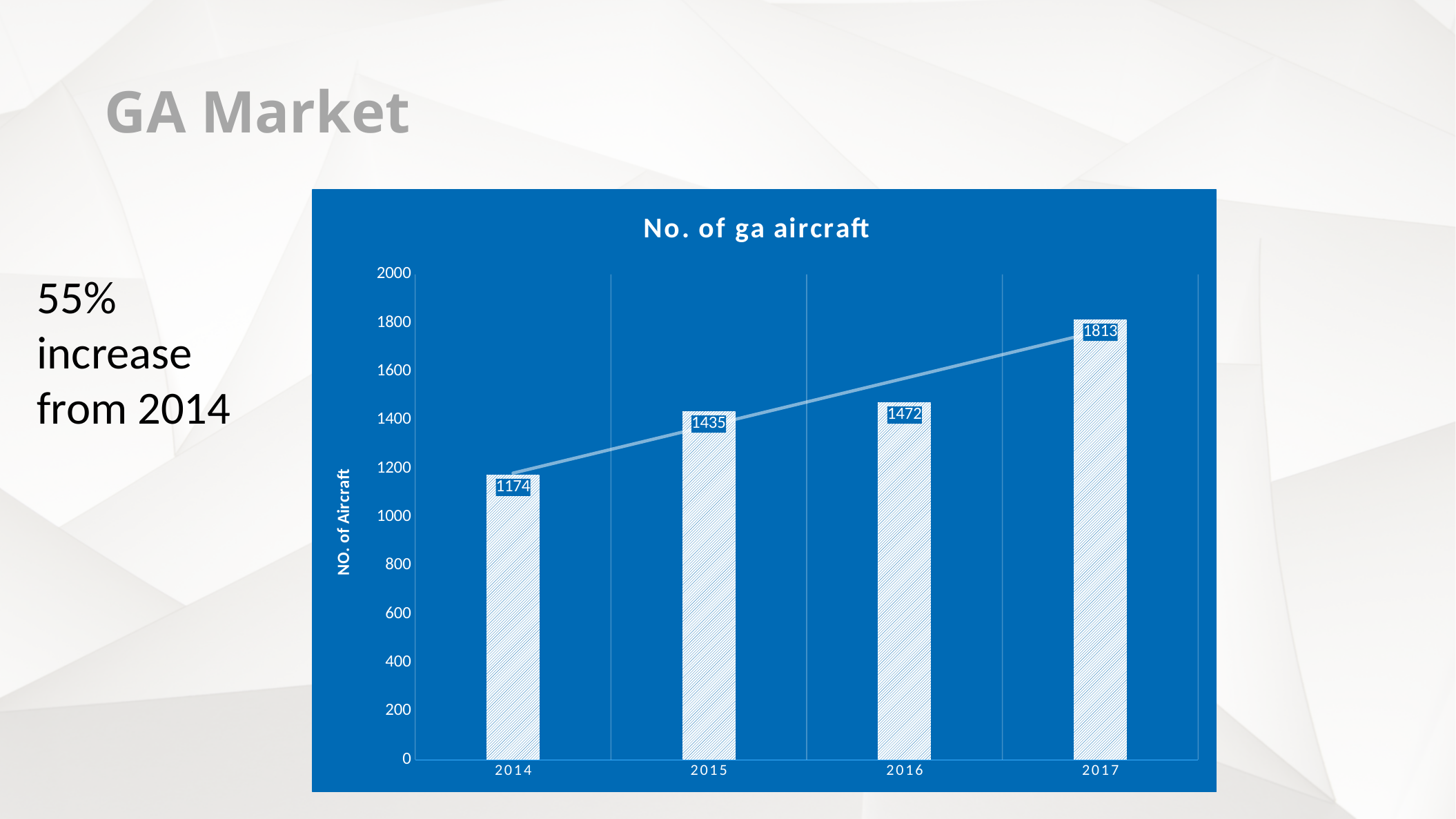
What is the number of GA aircraft in 2014? 1174 What is the difference in the number of GA aircraft between 2016 and 2015? 37 How many years are shown on the x axis of the chart? 4 What kind of chart is used to show the number of GA aircraft? Bar chart What is the number of GA aircraft in 2016? 1472 What is the number of GA aircraft in 2017? 1813 Which year has more GA aircraft, 2015 or 2017? 2017 What is the number of GA aircraft in 2015? 1435 Which year has the highest number of GA aircraft? 2017 Which year has the lowest number of GA aircraft? 2014 What is the difference in the number of GA aircraft between 2017 and 2014? 639 Do the values rise or fall from 2014 to 2017? Rise